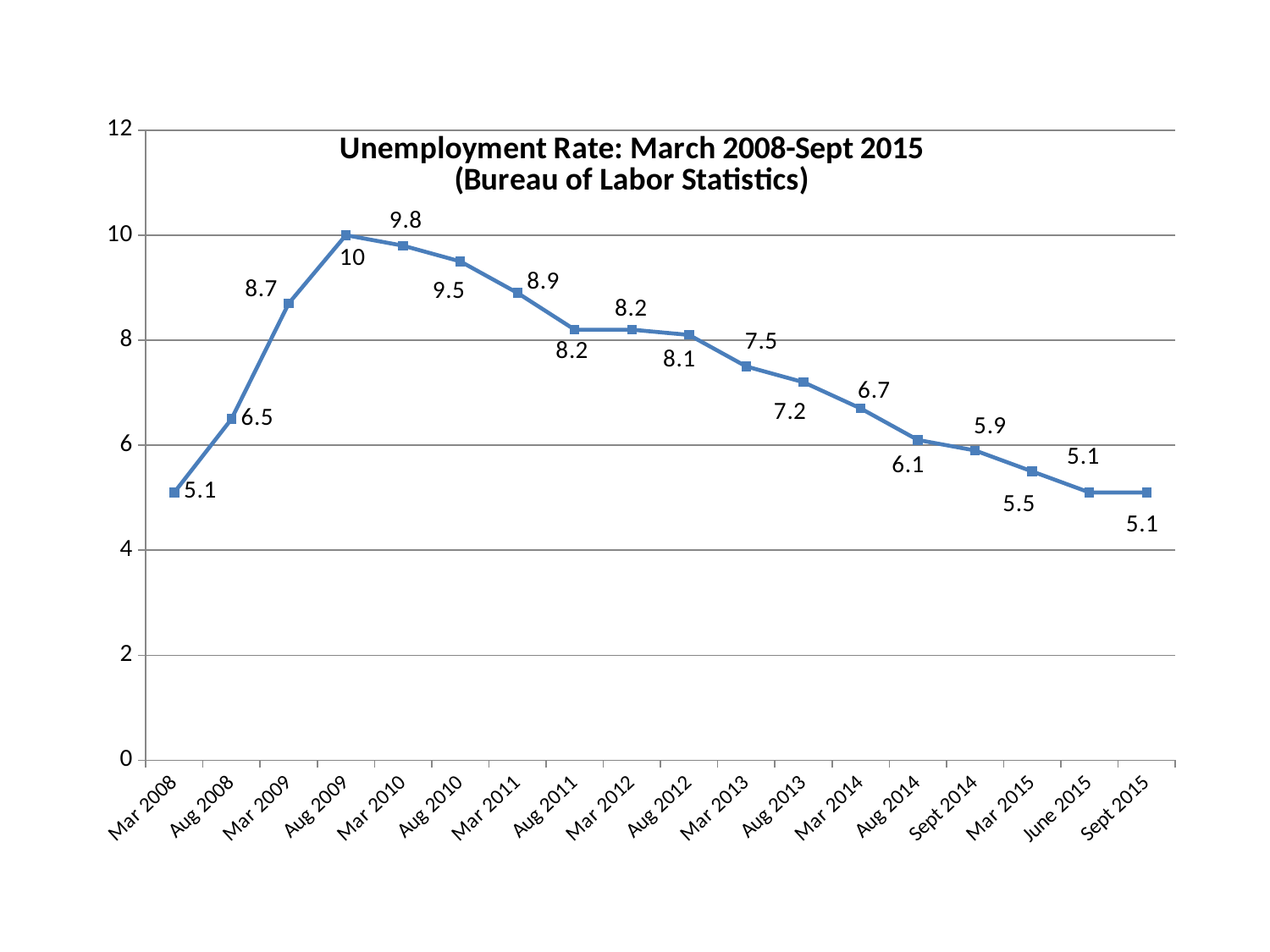
Does the unemployment rate rise or fall from Aug 2009 to Sept 2015? fall What is the unemployment rate for Mar 2013? 7.5 What is the unemployment rate for Aug 2014? 6.1 Which is higher, the unemployment rate in Mar 2010 or in Aug 2010? Mar 2010 What is the difference between the unemployment rate in Aug 2009 and in Sept 2015? 4.9 What is the title of the chart? Unemployment Rate: March 2008-Sept 2015 (Bureau of Labor Statistics) What is the unemployment rate for Aug 2009? 10 By how much did the unemployment rate rise from Mar 2008 to Mar 2009? 3.6 Which date has the highest unemployment rate? Aug 2009 What kind of chart is shown on the slide? line chart How many data points are plotted on the chart? 18 What is the lowest unemployment rate shown on the chart? 5.1